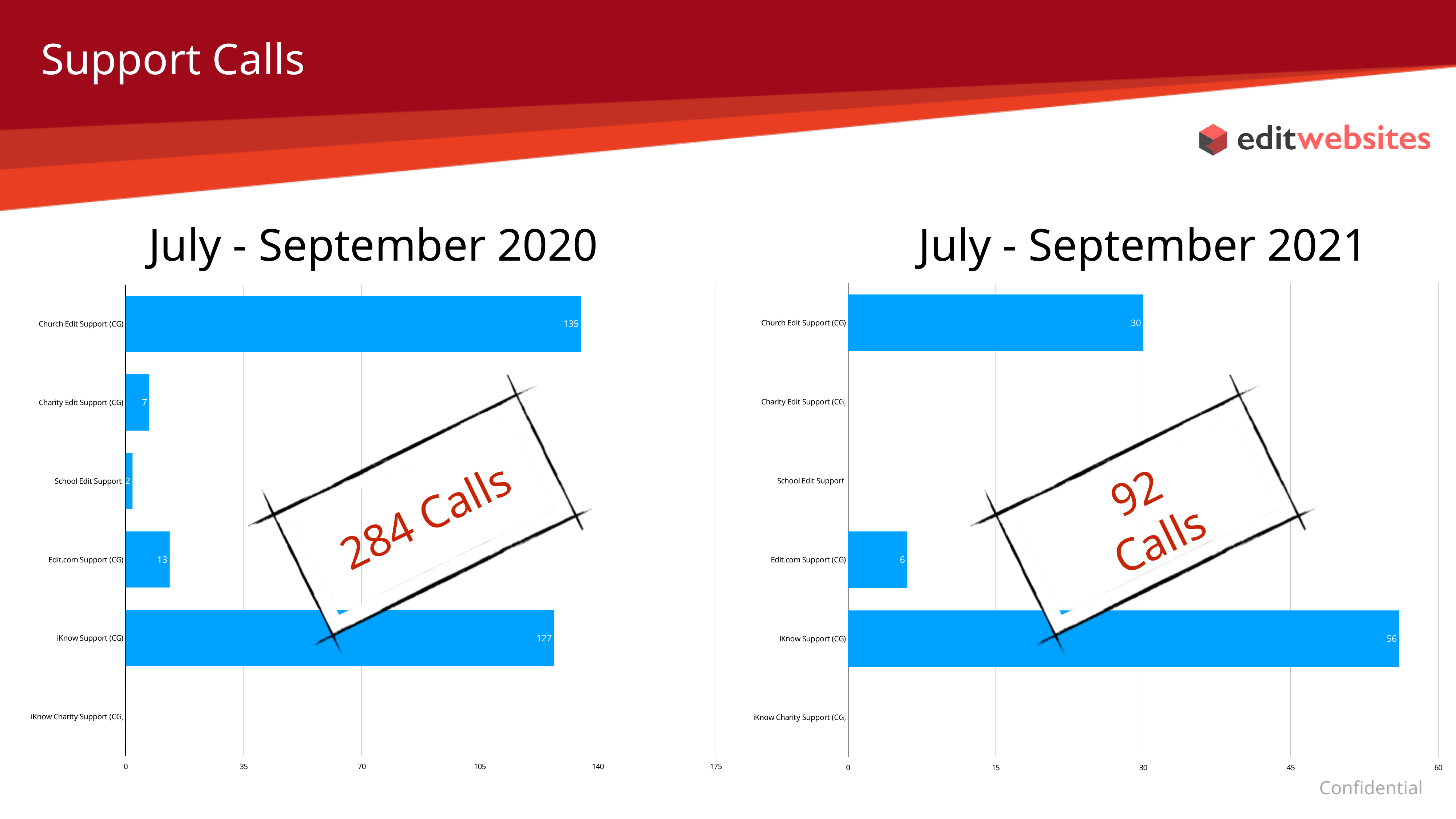
In the July - September 2021 chart, what is the value for Edit.com Support (CG)? 6 In the July - September 2021 chart, what is the value for iKnow Support (CG)? 56 In the July - September 2020 chart, what is the value for iKnow Support (CG)? 127 What kind of chart is the July - September 2020 chart? bar chart In the July - September 2020 chart, how many calls are shown for Church Edit Support (CG)? 135 What total is written in the stamp on the July - September 2021 chart? 92 Calls In the July - September 2020 chart, which category has the highest value? Church Edit Support (CG) In the July - September 2021 chart, what is the difference between iKnow Support (CG) and Church Edit Support (CG)? 26 In the July - September 2020 chart, which is larger: Edit.com Support (CG) or Charity Edit Support (CG)? Edit.com Support (CG) In the July - September 2020 chart, what is the difference between Church Edit Support (CG) and iKnow Support (CG)? 8 In the July - September 2021 chart, which category has the highest value? iKnow Support (CG) In the July - September 2021 chart, is the value for iKnow Support (CG) greater or less than 45? greater